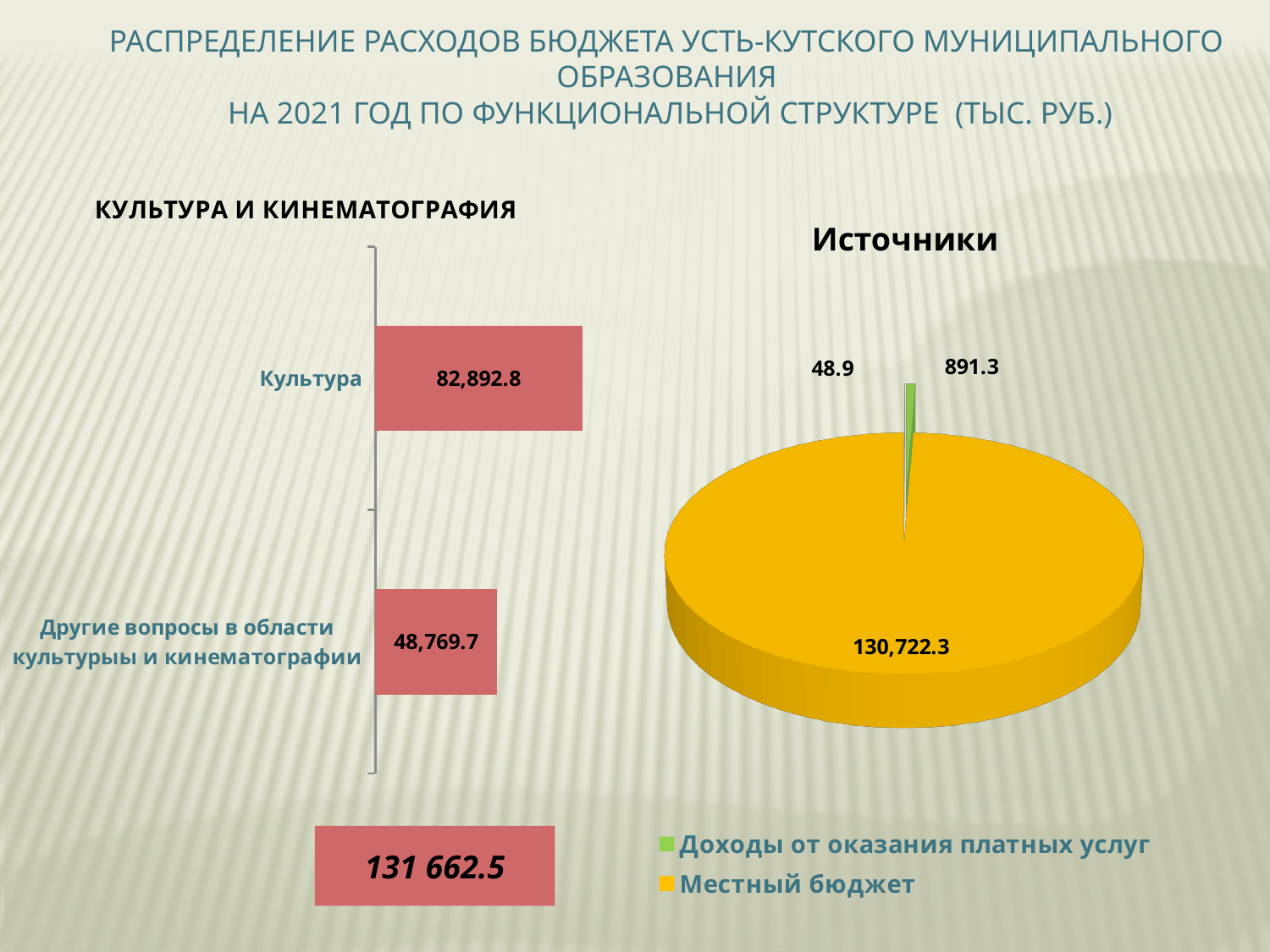
In the bar chart 'КУЛЬТУРА И КИНЕМАТОГРАФИЯ', what is the value for 'Другие вопросы в области культурыы и кинематографии'? 48,769.7 How many entries does the legend of the pie chart 'Источники' list? 2 What kind of chart is the chart titled 'Источники'? pie chart In the bar chart 'КУЛЬТУРА И КИНЕМАТОГРАФИЯ', which category has the lowest value? Другие вопросы в области культурыы и кинематографии What kind of chart is the chart titled 'КУЛЬТУРА И КИНЕМАТОГРАФИЯ'? bar chart In the pie chart 'Источники', which legend entry corresponds to the largest slice? Местный бюджет How many categories are shown in the bar chart 'КУЛЬТУРА И КИНЕМАТОГРАФИЯ'? 2 In the bar chart 'КУЛЬТУРА И КИНЕМАТОГРАФИЯ', what is the difference between the value for 'Культура' and the value for 'Другие вопросы в области культурыы и кинематографии'? 34,123.1 In the bar chart 'КУЛЬТУРА И КИНЕМАТОГРАФИЯ', which category has the highest value? Культура In the bar chart 'КУЛЬТУРА И КИНЕМАТОГРАФИЯ', what is the value for 'Культура'? 82,892.8 In the pie chart 'Источники', what is the value for 'Местный бюджет'? 130,722.3 In the bar chart 'КУЛЬТУРА И КИНЕМАТОГРАФИЯ', which is larger: the value for 'Культура' or the value for 'Другие вопросы в области культурыы и кинематографии'? Культура